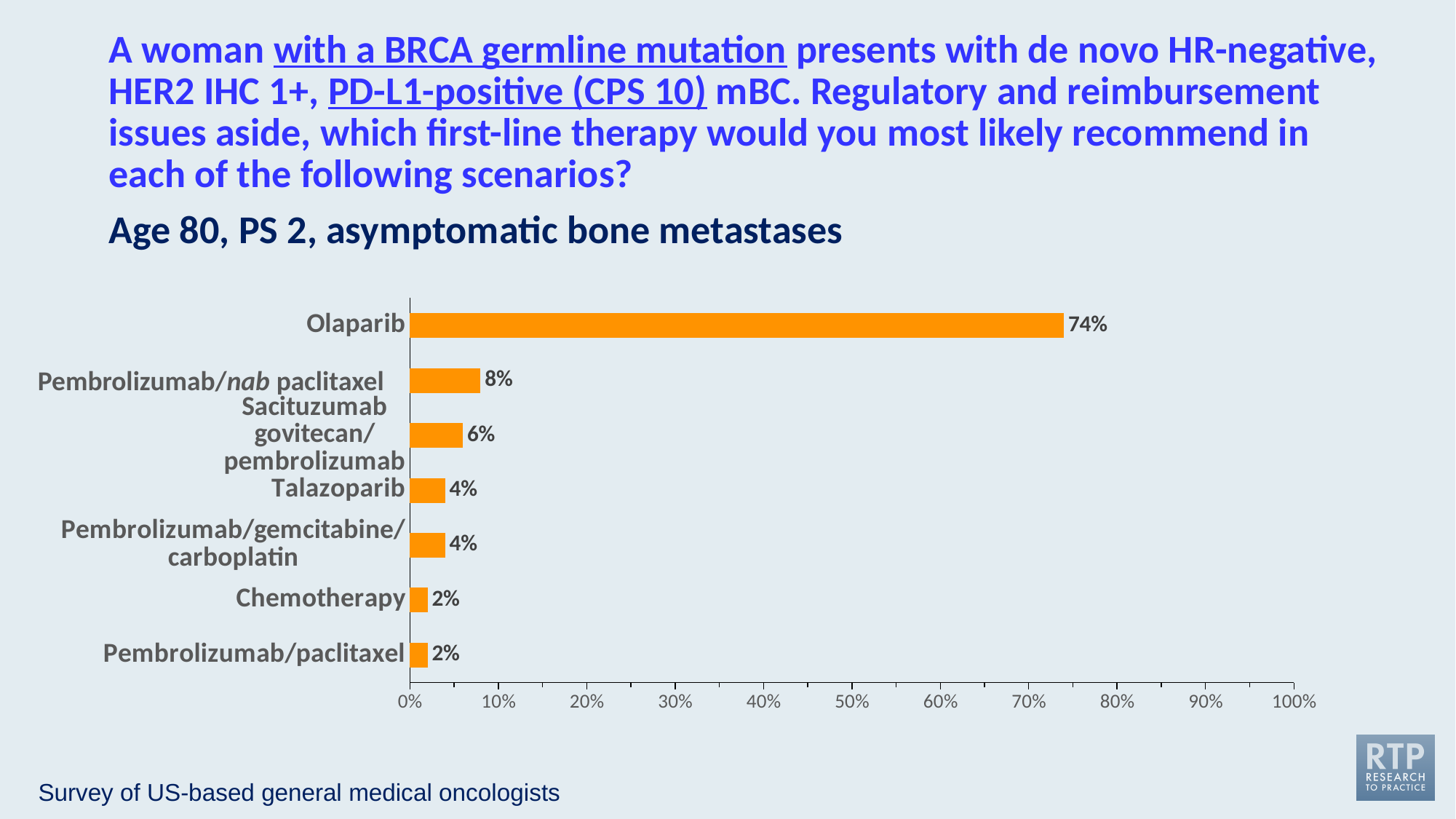
What is the maximum value shown on the horizontal axis? 100% What type of chart is shown on the slide? Bar chart Which received a larger share of responses, Talazoparib or Sacituzumab govitecan/pembrolizumab? Sacituzumab govitecan/pembrolizumab What percentage of respondents chose Talazoparib? 4% What percentage of respondents chose Olaparib? 74% How many therapy options are shown in the chart? 7 What percentage of respondents chose Pembrolizumab/nab paclitaxel? 8% Which therapy received the highest percentage of responses? Olaparib Is the value for Olaparib greater or less than 70%? greater What percentage of respondents chose Chemotherapy? 2% What is the difference in percentage between Olaparib and Pembrolizumab/nab paclitaxel? 66% What percentage of respondents chose Sacituzumab govitecan/pembrolizumab? 6%